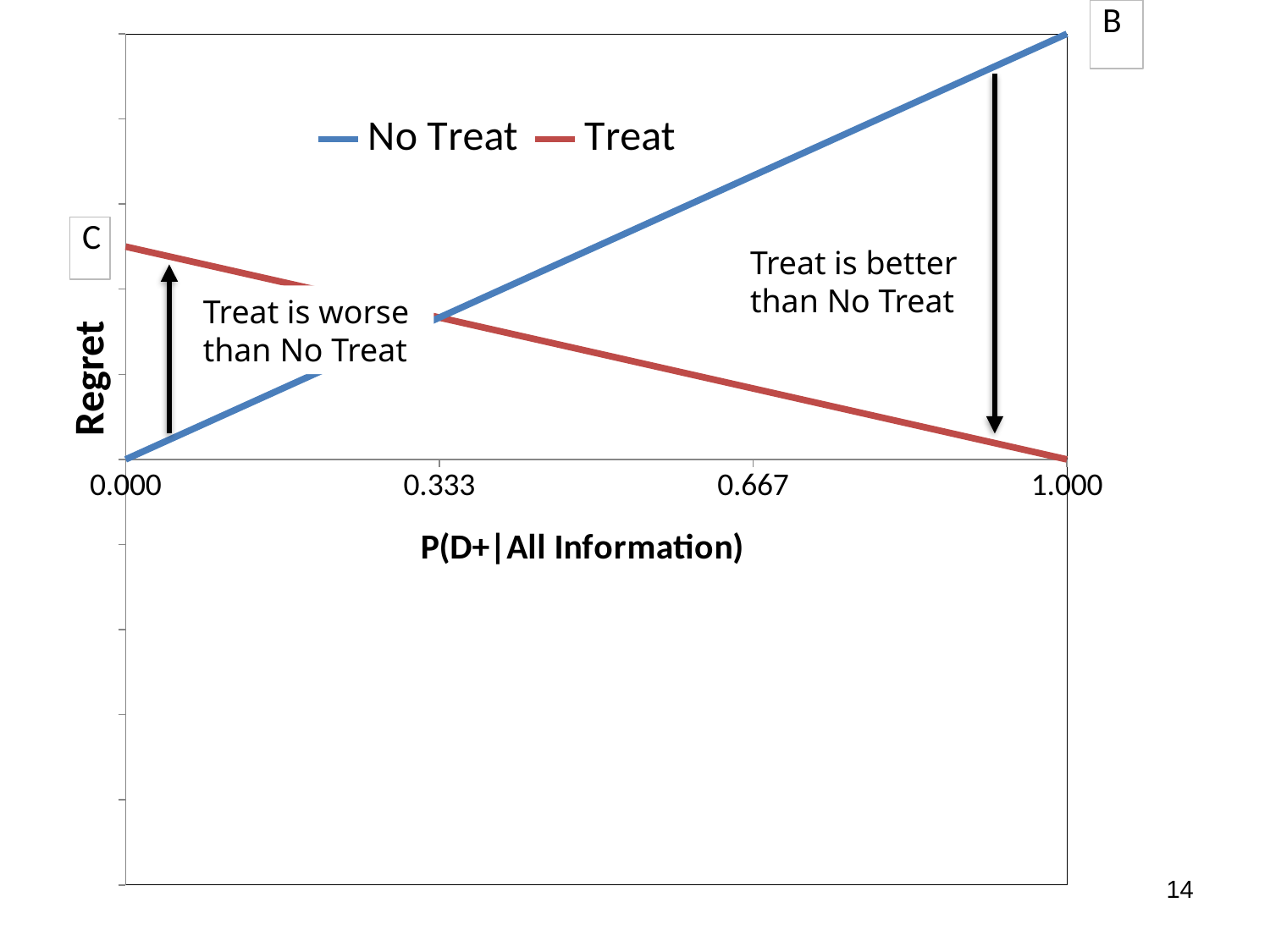
What is the title of the x axis? P(D+|All Information) How many series does the legend list? 2 How many labelled tick values are shown on the x axis? 4 At what value of P(D+|All Information) do the No Treat and Treat lines cross? 0.333 Does the No Treat line rise or fall as P(D+|All Information) increases? rises At P(D+|All Information) = 0.000, which series has the higher regret, No Treat or Treat? Treat What are the two series named in the legend? No Treat and Treat Which series reaches the highest regret anywhere on the chart? No Treat At P(D+|All Information) = 1.000, which series has the higher regret, No Treat or Treat? No Treat Does the Treat line rise or fall as P(D+|All Information) increases? falls What kind of chart is shown on the slide? line chart